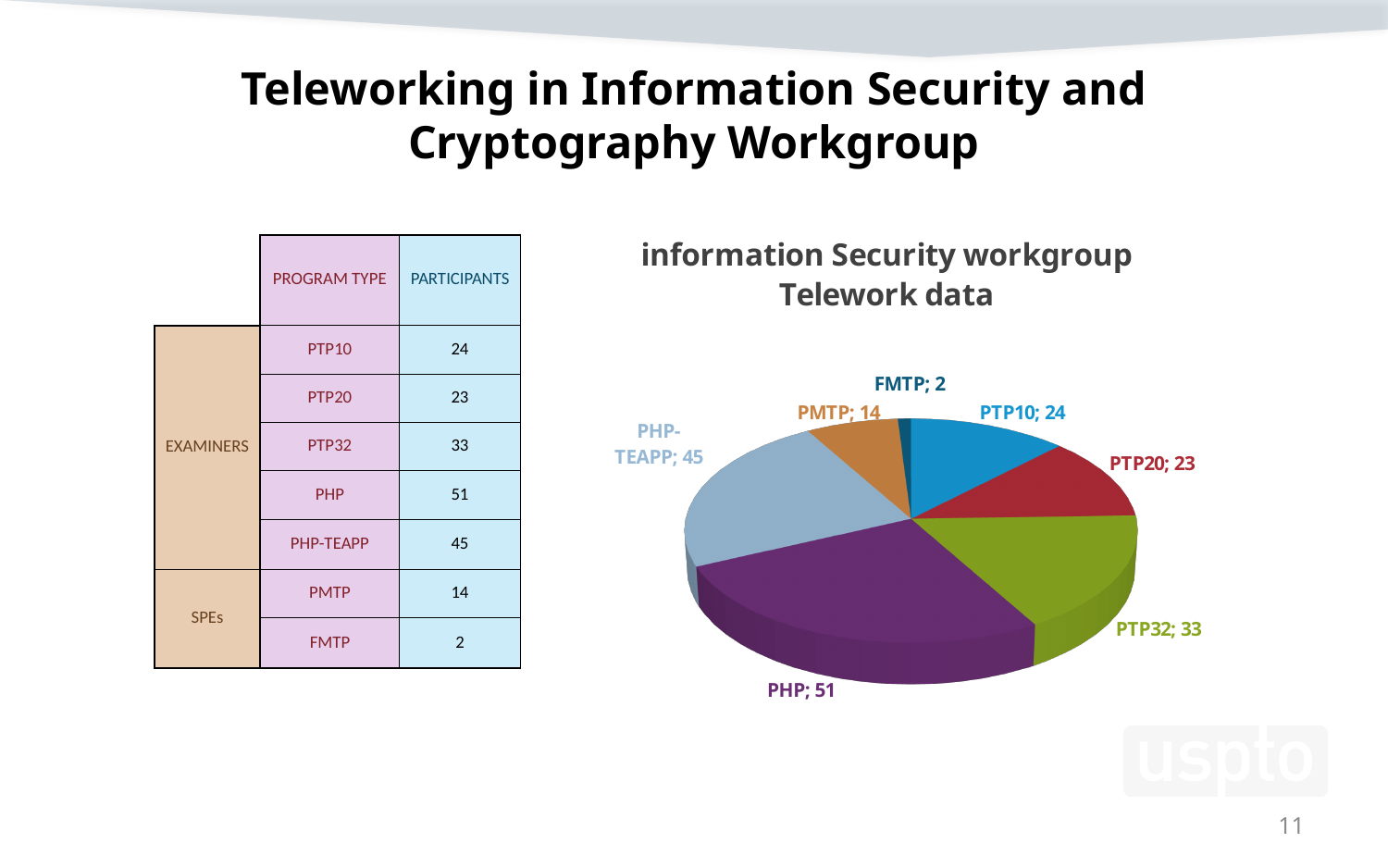
What is the total of all the values shown in the pie chart? 192 Which program type has the largest slice in the pie chart? PHP Which is larger in the pie chart, PTP32 or PMTP? PTP32 What is the value for PHP in the pie chart? 51 Which program type has the smallest slice in the pie chart? FMTP What is the value for PMTP in the pie chart? 14 What is the difference between the values for PTP32 and PTP10? 9 What is the title of the chart? information Security workgroup Telework data What kind of chart is shown on the slide? pie chart How many slices does the pie chart have? 7 What is the value for PHP-TEAPP in the pie chart? 45 What is the difference between the values for PHP and PHP-TEAPP? 6